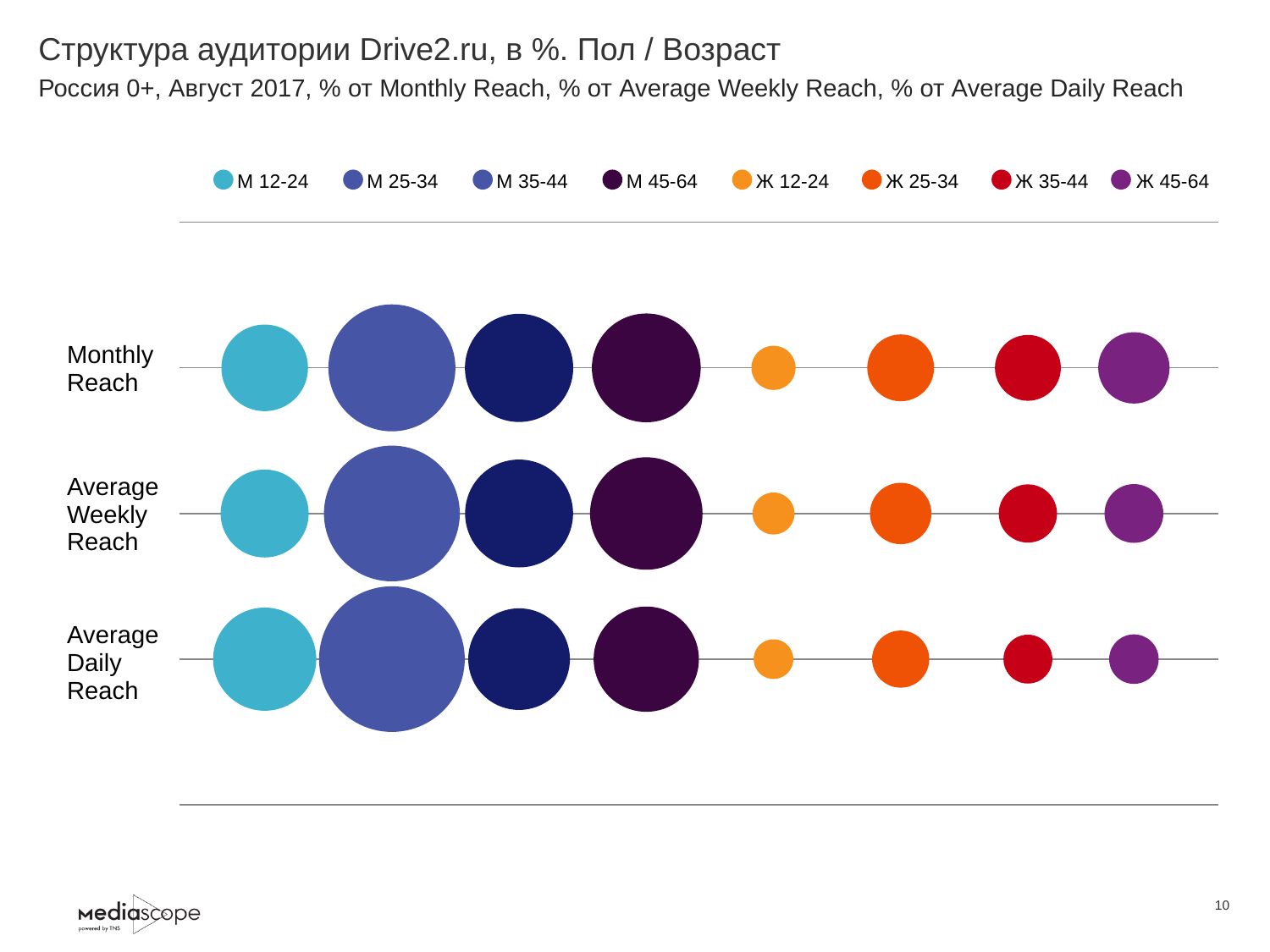
In the Monthly Reach row, which bubble is larger: М 45-64 or Ж 25-34? М 45-64 Which group has the largest bubble in the Monthly Reach row? М 25-34 What kind of chart is shown on the slide? Bubble chart Does the М 25-34 bubble get larger or smaller going from Monthly Reach to Average Daily Reach? Larger How many reach categories (rows) are plotted on the chart? 3 Does the Ж 45-64 bubble get larger or smaller going from Monthly Reach to Average Daily Reach? Smaller Which month and year does the chart's data refer to? Август 2017 How many series does the legend list? 8 In the Average Daily Reach row, which bubble is larger: М 12-24 or Ж 35-44? М 12-24 Which group has the smallest bubble in the Monthly Reach row? Ж 12-24 Which group has the largest bubble in the Average Daily Reach row? М 25-34 Which website's audience structure is shown in the chart title? Drive2.ru